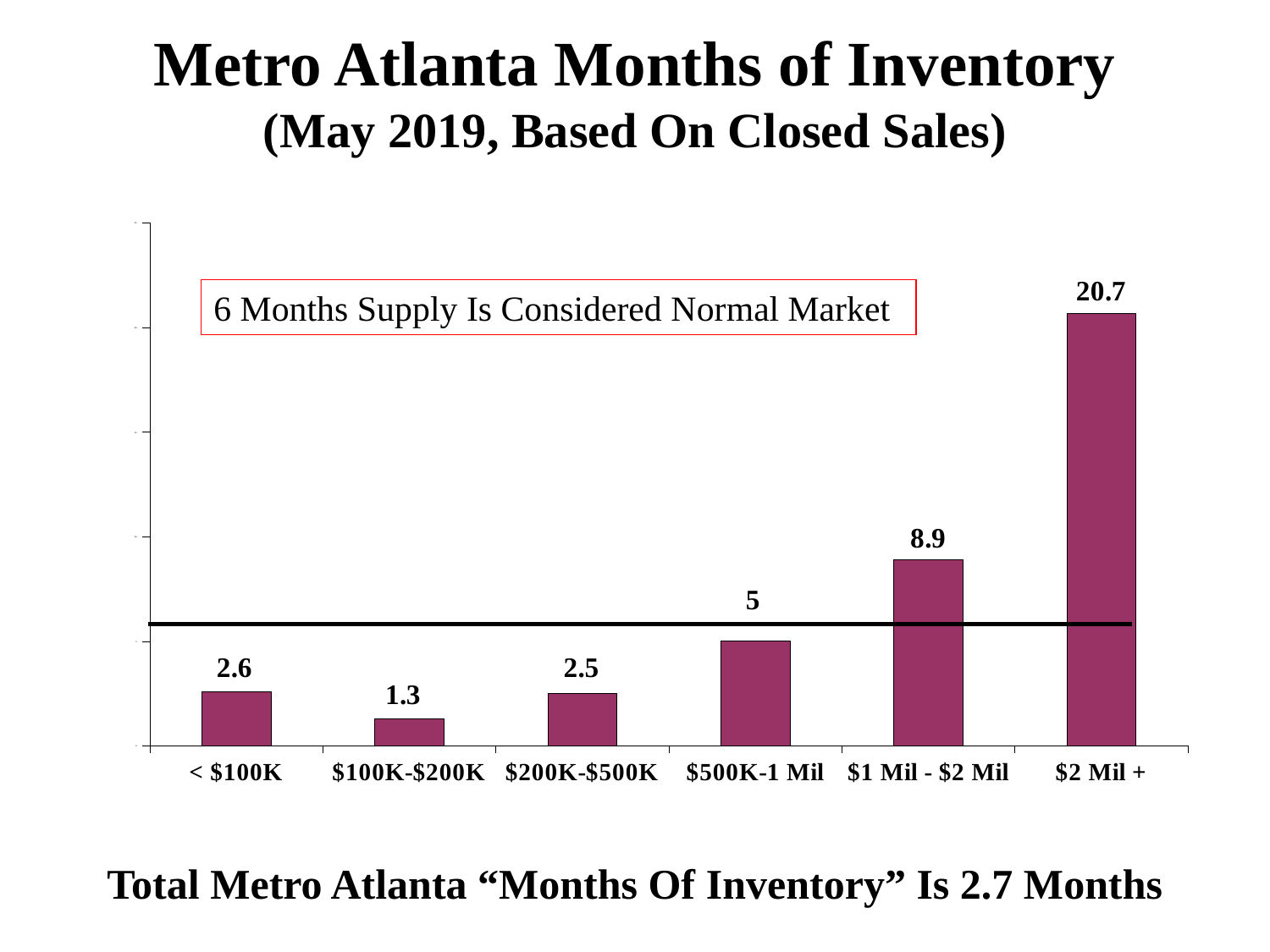
What is the months of inventory value for the $2 Mil + price range? 20.7 What is the months of inventory value for the < $100K price range? 2.6 Which price range has the highest months of inventory? $2 Mil + What is the difference in months of inventory between the $2 Mil + and $1 Mil - $2 Mil price ranges? 11.8 How many price range categories are shown on the chart? 6 According to the text box on the chart, how many months of supply is considered a normal market? 6 Months What is the months of inventory value for the $500K-1 Mil price range? 5 Which price range has the lowest months of inventory? $100K-$200K Do the months of inventory values generally rise or fall as the price range increases from $200K-$500K to $2 Mil +? Rise What is the months of inventory value for the $100K-$200K price range? 1.3 What kind of chart is shown on the slide? Bar chart Which has a higher months of inventory value, $1 Mil - $2 Mil or $500K-1 Mil? $1 Mil - $2 Mil